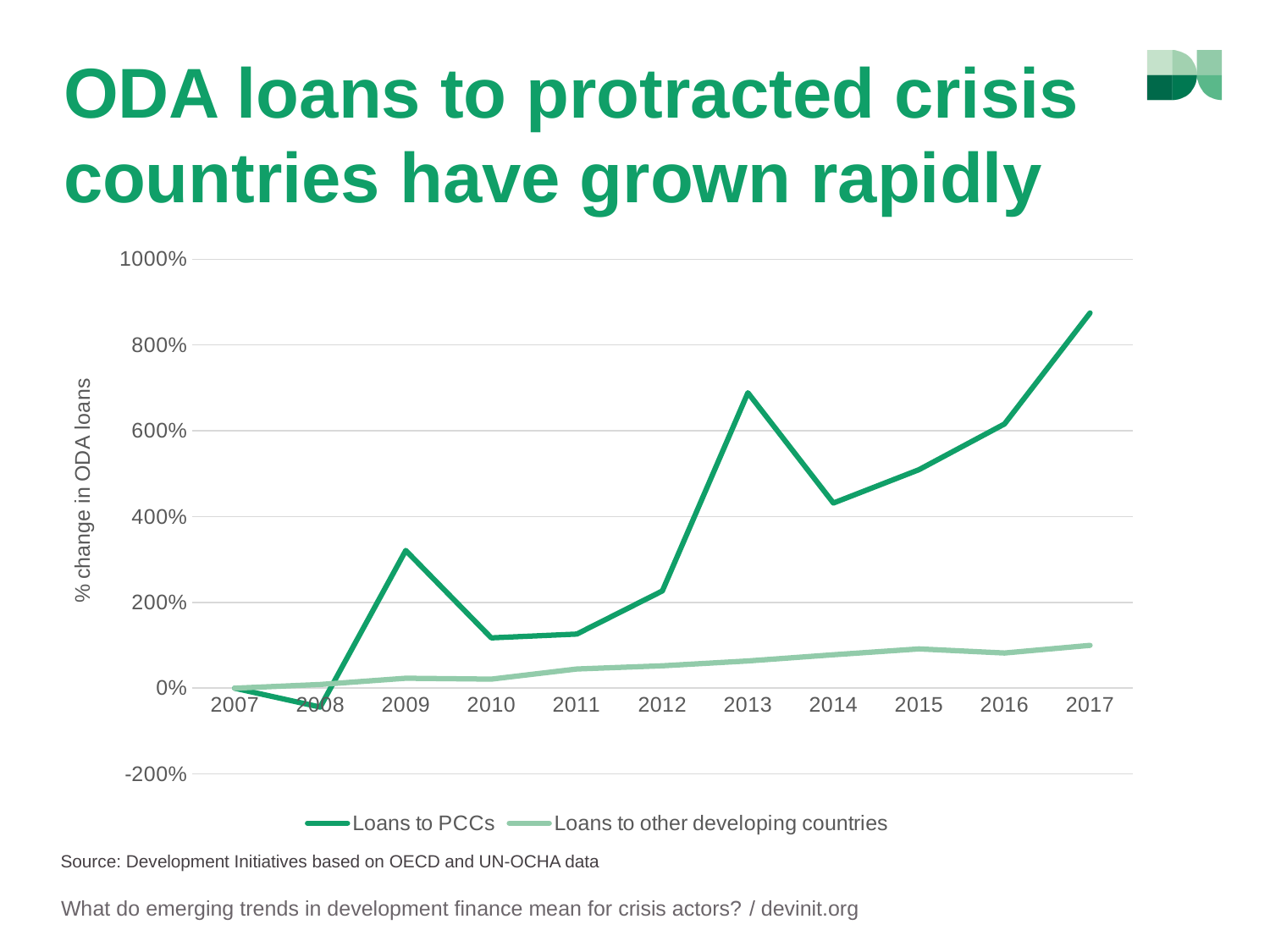
How many series does the legend list? 2 Which series has the higher value in 2017: Loans to PCCs or Loans to other developing countries? Loans to PCCs Is the value for Loans to PCCs in 2010 greater or less than 200%? less In which year does the Loans to PCCs series reach its highest value? 2017 Is the value for Loans to PCCs in 2017 greater or less than 800%? greater What is the label on the y axis? % change in ODA loans How many years are shown on the x axis? 11 Is the value for Loans to other developing countries in 2017 greater or less than 200%? less Which is larger for Loans to PCCs: the value in 2013 or the value in 2014? 2013 In which year does the Loans to PCCs series reach its lowest value? 2008 What kind of chart is shown on the slide? Line chart